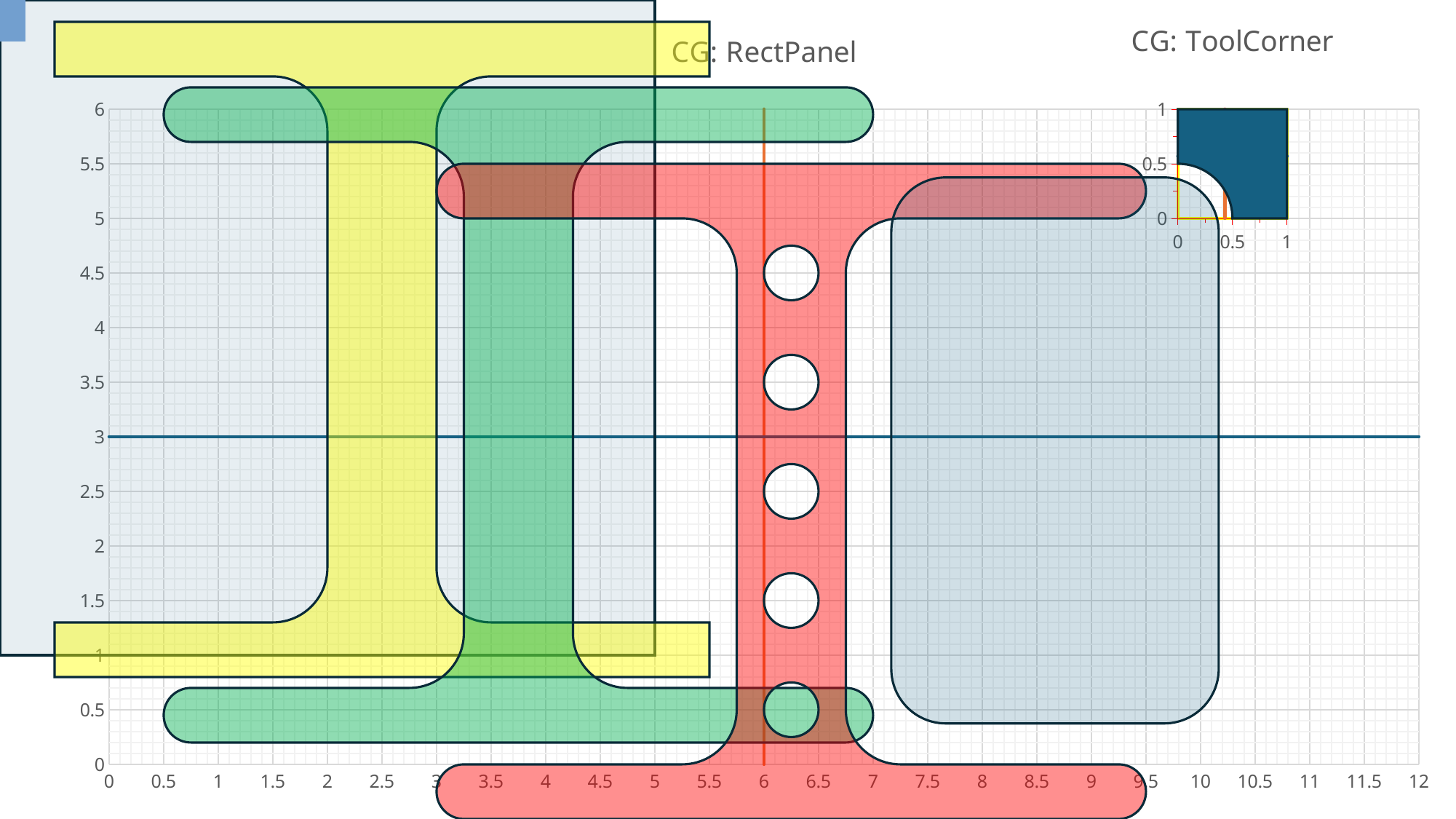
In the CG: RectPanel chart, how many circular holes are cut in the red shape? 5 In the CG: ToolCorner chart, what is the largest value labelled on the x axis? 1 What is the title of the small chart in the top right? CG: ToolCorner In the CG: RectPanel chart, what is the largest value labelled on the x axis? 12 What is the title of the large chart on the left? CG: RectPanel In the CG: RectPanel chart, what is the largest value labelled on the y axis? 6